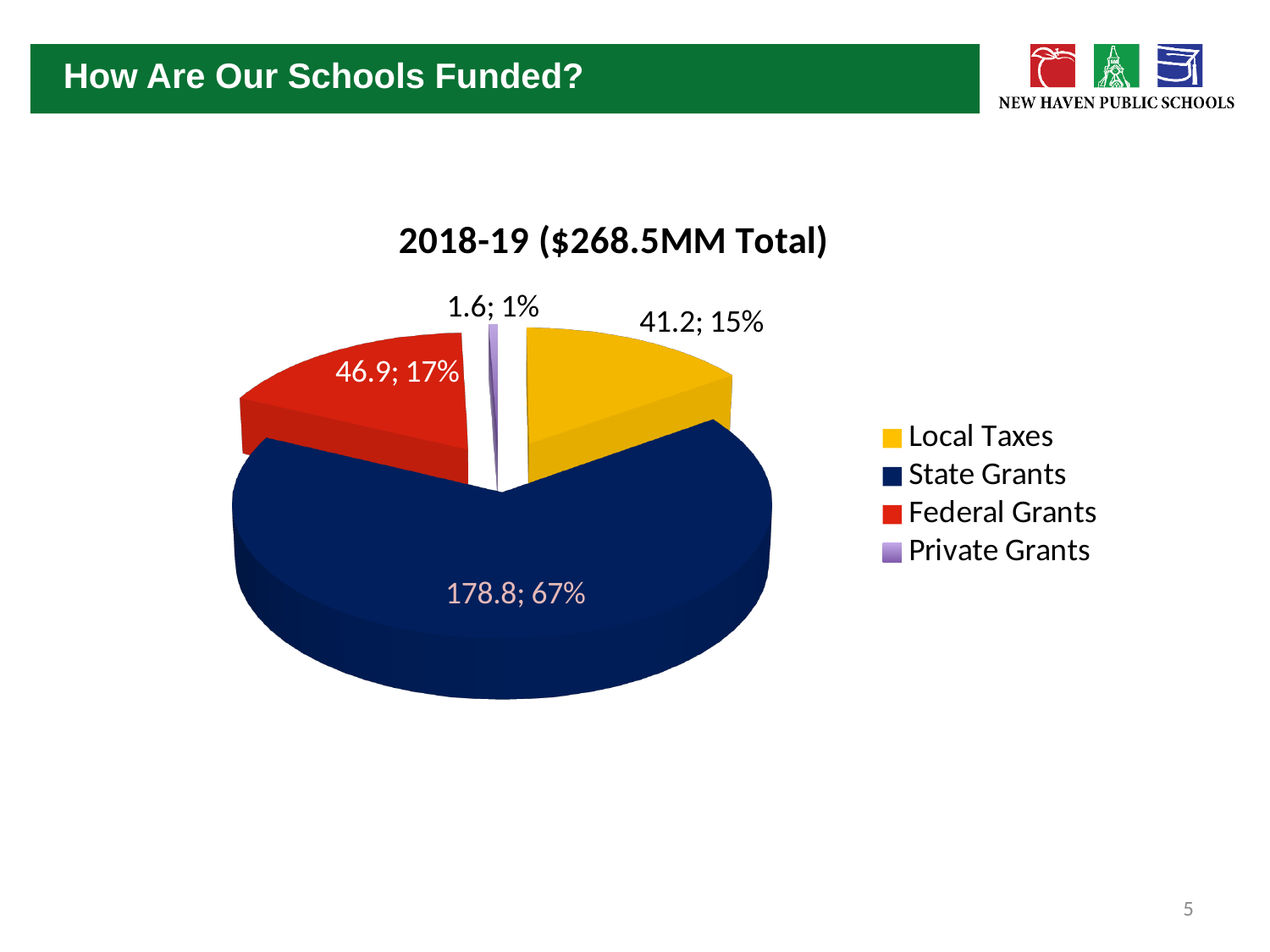
What is the value shown for Private Grants? 1.6 How many categories does the legend list? 4 What share of the pie does State Grants represent? 67% Which funding source is the largest slice of the pie? State Grants What share of the pie does Federal Grants represent? 17% What is the value shown for Federal Grants? 46.9 What kind of chart is shown on the slide? pie chart What is the value shown for State Grants? 178.8 What is the value shown for Local Taxes? 41.2 Which funding source is the smallest slice of the pie? Private Grants What is the difference between the values for Federal Grants and Local Taxes? 5.7 What is the chart's title? 2018-19 ($268.5MM Total)